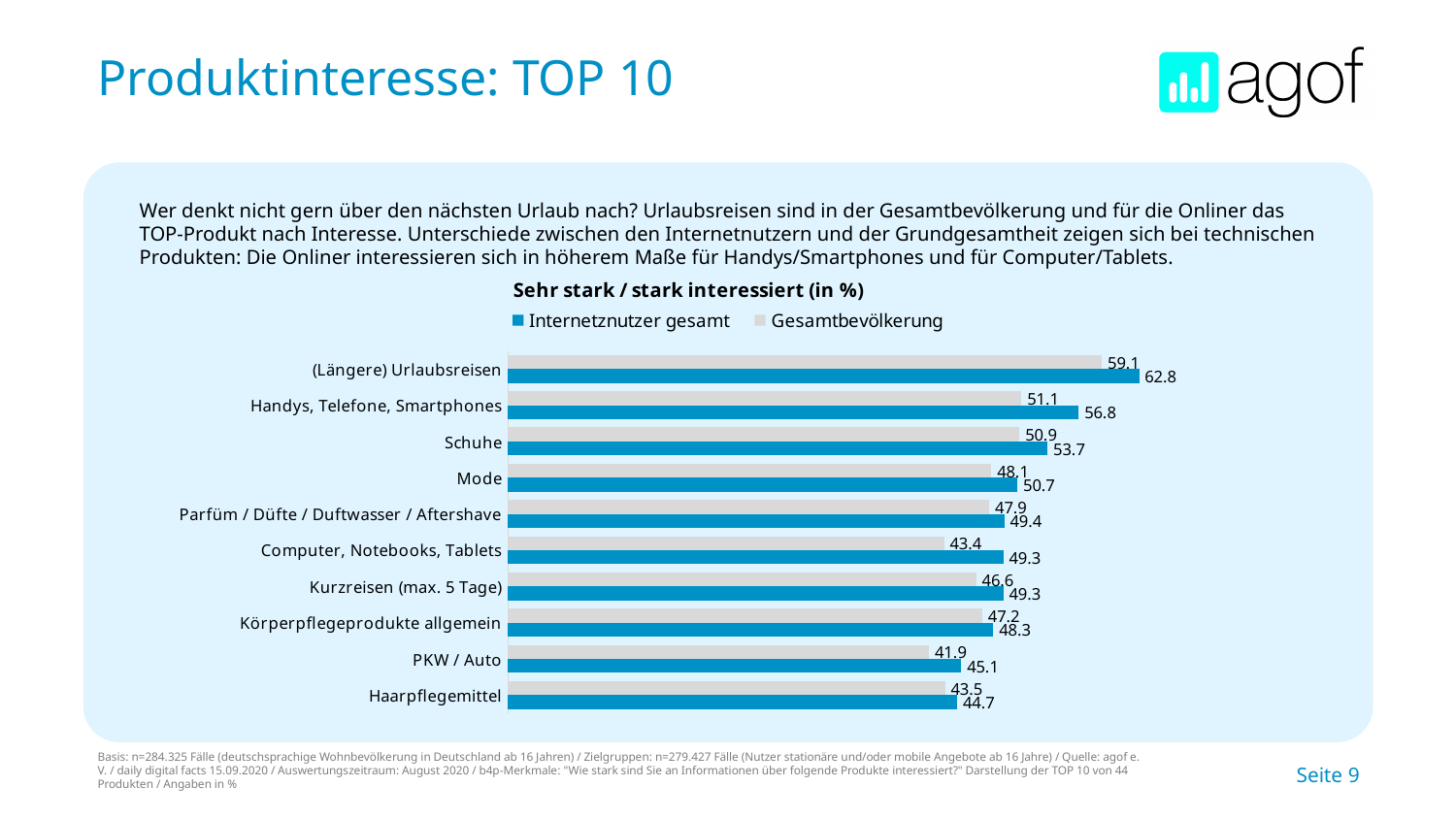
Which category has the highest value for Internetnutzer gesamt? (Längere) Urlaubsreisen What kind of chart is shown on the slide? bar chart What is the difference between Internetnutzer gesamt and Gesamtbevölkerung for Computer, Notebooks, Tablets? 5,9 How many product categories are shown in the chart? 10 Which category has the lowest value for Gesamtbevölkerung? PKW / Auto What is the value for Internetnutzer gesamt for PKW / Auto? 45,1 What is the title of the chart? Sehr stark / stark interessiert (in %) How many series does the legend list? 2 Which is larger for Schuhe: the value for Internetnutzer gesamt or for Gesamtbevölkerung? Internetnutzer gesamt What is the value for Gesamtbevölkerung for Computer, Notebooks, Tablets? 43,4 What is the value for Internetnutzer gesamt for (Längere) Urlaubsreisen? 62,8 What is the difference between Internetnutzer gesamt and Gesamtbevölkerung for Handys, Telefone, Smartphones? 5,7